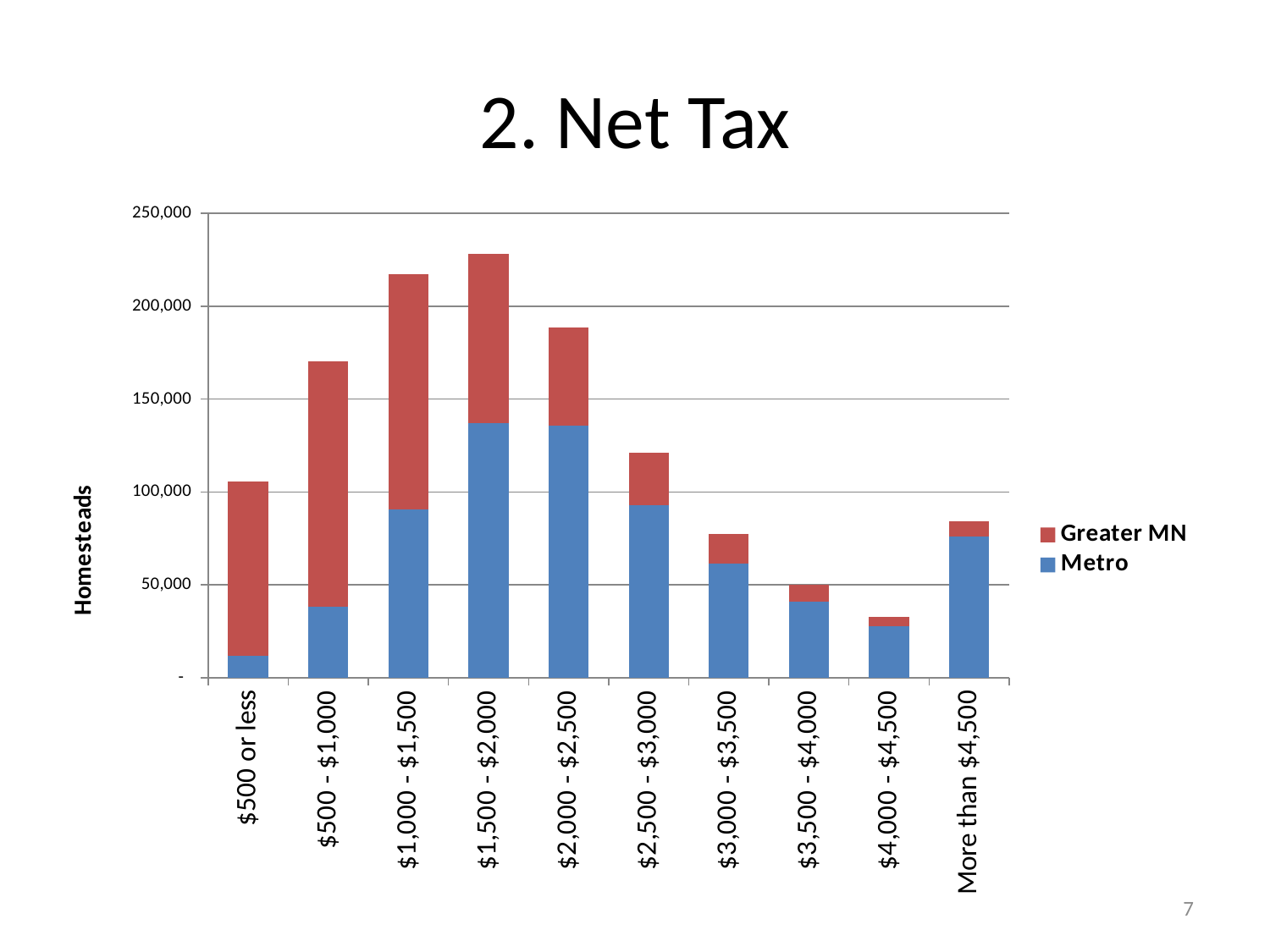
Which has the larger Metro value: $3,000 - $3,500 or $3,500 - $4,000? $3,000 - $3,500 How many series does the legend list? 2 Which net tax category has the lowest total number of homesteads? $4,000 - $4,500 Which net tax category has the smallest Metro value? $500 or less What is the label on the vertical axis? Homesteads Is the Metro value for $500 - $1,000 greater or less than 50,000? less Do the total homestead counts rise or fall from $1,500 - $2,000 through $4,000 - $4,500? fall Is the total number of homesteads for $2,000 - $2,500 greater or less than 150,000? greater What kind of chart is shown on the slide? Stacked bar chart How many net tax categories are shown on the x axis? 10 Is the Metro value for $1,500 - $2,000 greater or less than 100,000? greater Which net tax category has the highest total number of homesteads? $1,500 - $2,000